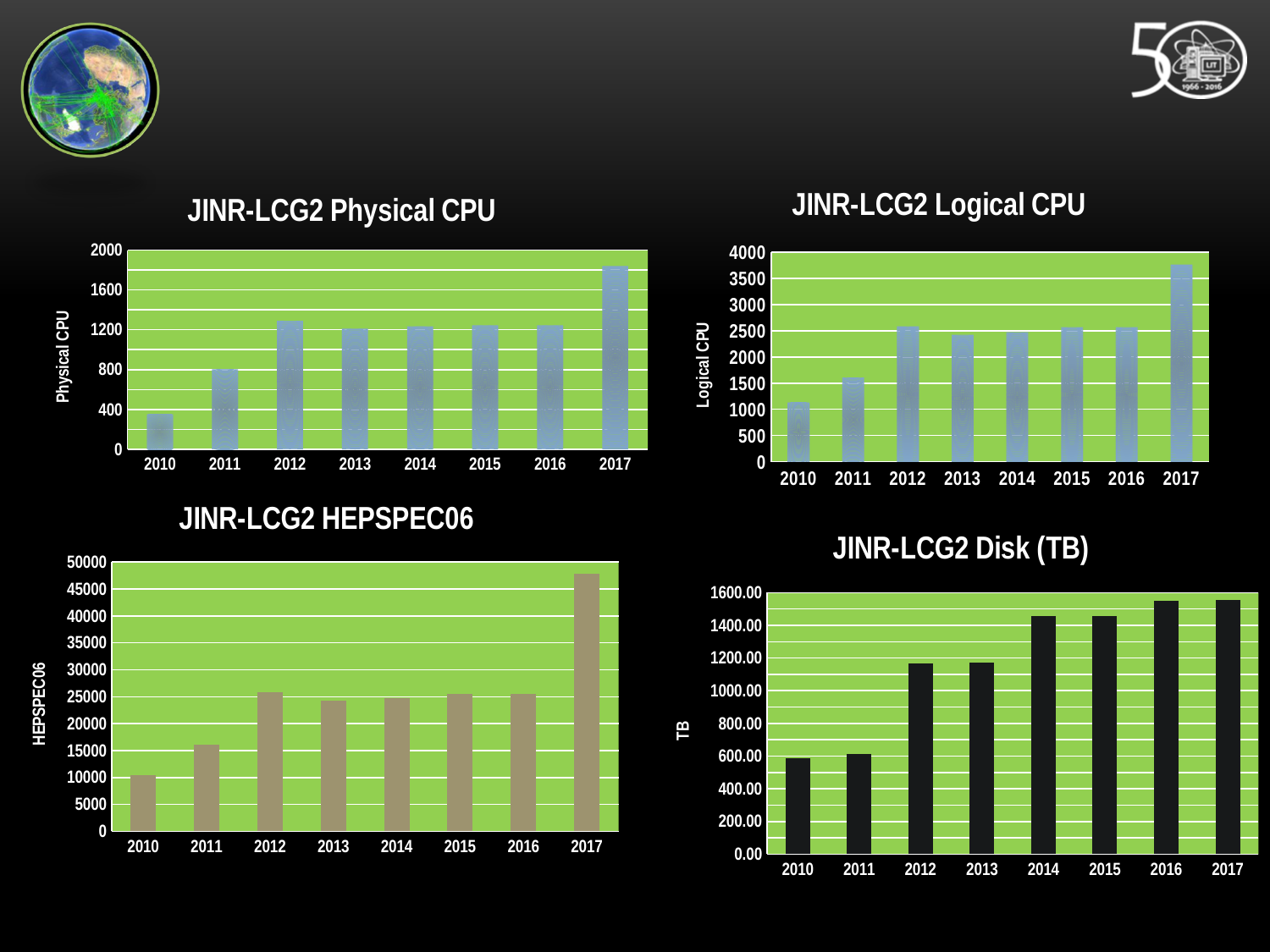
How many years are shown on the x axis of the JINR-LCG2 Disk (TB) chart? 8 In the JINR-LCG2 HEPSPEC06 chart, which year has the highest value? 2017 In the JINR-LCG2 Physical CPU chart, which year has the highest value? 2017 In the JINR-LCG2 Logical CPU chart, is the value for 2017 greater or less than 3500? greater In the JINR-LCG2 Logical CPU chart, which year has the lowest value? 2010 In the JINR-LCG2 Disk (TB) chart, is the value for 2014 greater or less than 1400.00? greater What kind of chart is the JINR-LCG2 HEPSPEC06 chart? bar chart In the JINR-LCG2 Physical CPU chart, which year has the lowest value? 2010 In the JINR-LCG2 Logical CPU chart, is the value for 2011 larger or smaller than the value for 2012? smaller In the JINR-LCG2 Physical CPU chart, is the value for 2017 greater or less than 1600? greater